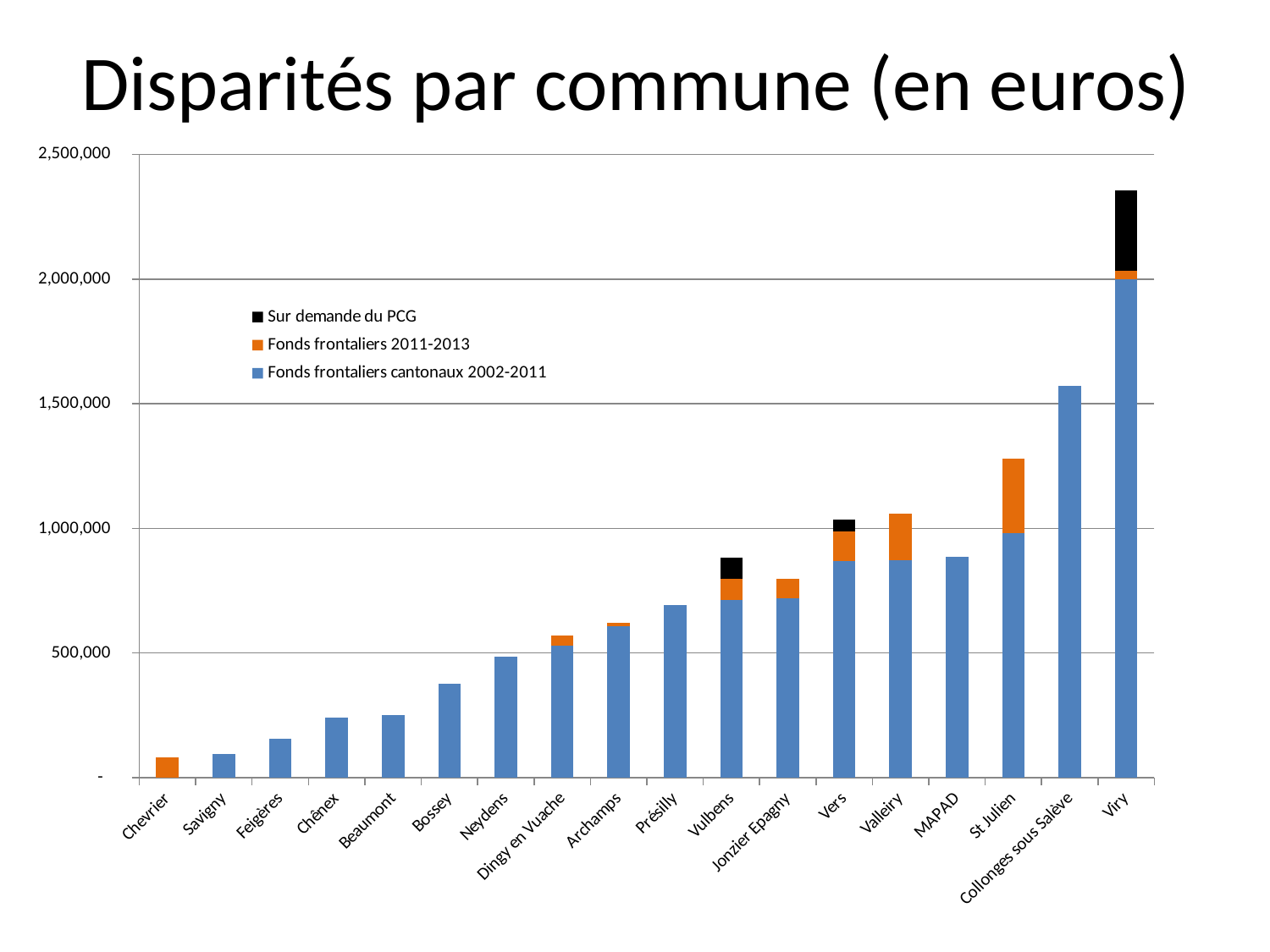
How many communes (categories) are shown on the x axis? 18 What kind of chart is shown on the slide? stacked bar chart Which commune has the highest total bar? Viry Is the value for Bossey greater or less than 500,000? less Which has the larger total bar, Collonges sous Salève or St Julien? Collonges sous Salève Is the total value for Collonges sous Salève greater or less than 1,500,000? greater What is the title of the chart? Disparités par commune (en euros) Is the total value for Viry greater or less than 2,000,000? greater Which colour represents the series 'Sur demande du PCG' in the legend? black How many series does the legend list? 3 Do the total bar values generally rise or fall from left to right along the x axis? rise